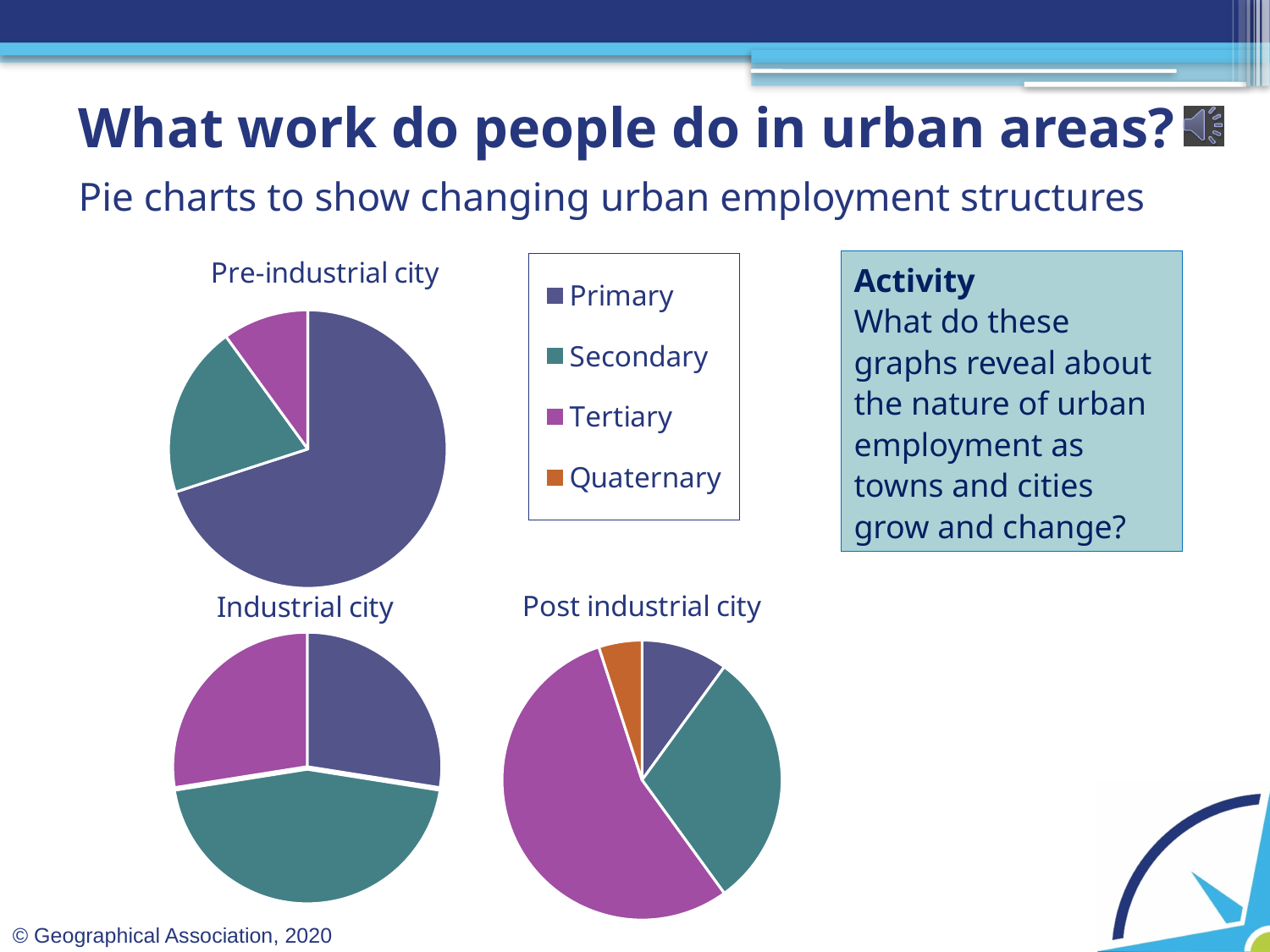
How many pie charts are shown on the slide? 3 In the Pre-industrial city chart, which is larger, the Primary slice or the Secondary slice? Primary In the Pre-industrial city chart, which employment sector has the smallest slice? Tertiary How many slices does the Post industrial city pie chart have? 4 What kind of chart is the Pre-industrial city chart? Pie chart In the Industrial city chart, which employment sector has the largest slice? Secondary In the Post industrial city chart, which employment sector has the smallest slice? Quaternary In the Post industrial city chart, which employment sector has the largest slice? Tertiary Which colour represents Quaternary employment in the legend? Orange In the Pre-industrial city chart, which employment sector has the largest slice? Primary How many categories does the legend list? 4 In the Post industrial city chart, which is larger, the Primary slice or the Secondary slice? Secondary